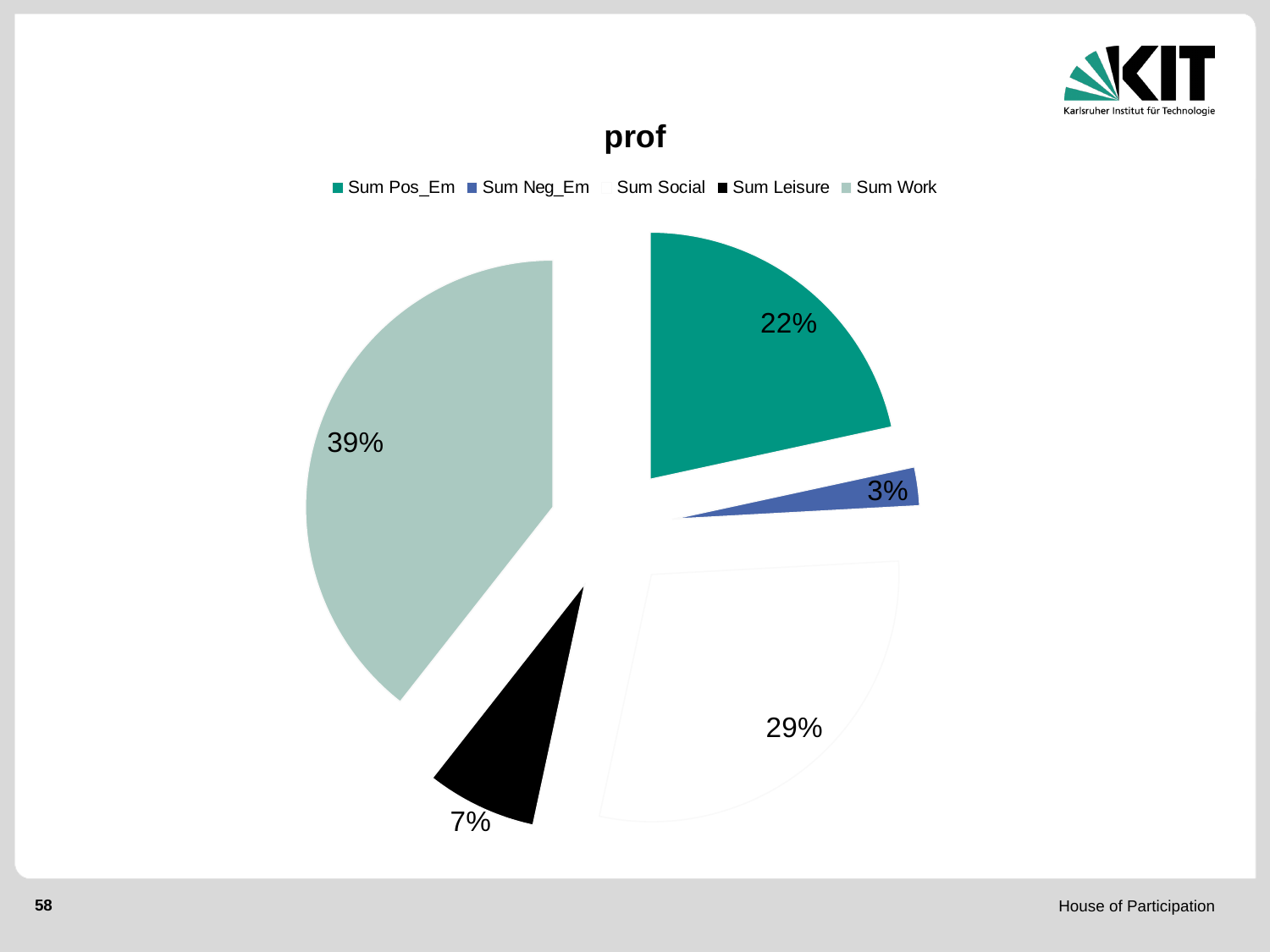
What is the difference in percentage points between Sum Work and Sum Social? 10% What share of the pie does Sum Work have? 39% What share of the pie does Sum Pos_Em have? 22% What share of the pie does Sum Social have? 29% How many entries does the legend list? 5 What is the title of the chart? prof What kind of chart is shown on the slide? pie chart Which category has the largest slice of the pie? Sum Work Which is larger, the share for Sum Pos_Em or the share for Sum Leisure? Sum Pos_Em Which category has the smallest slice of the pie? Sum Neg_Em